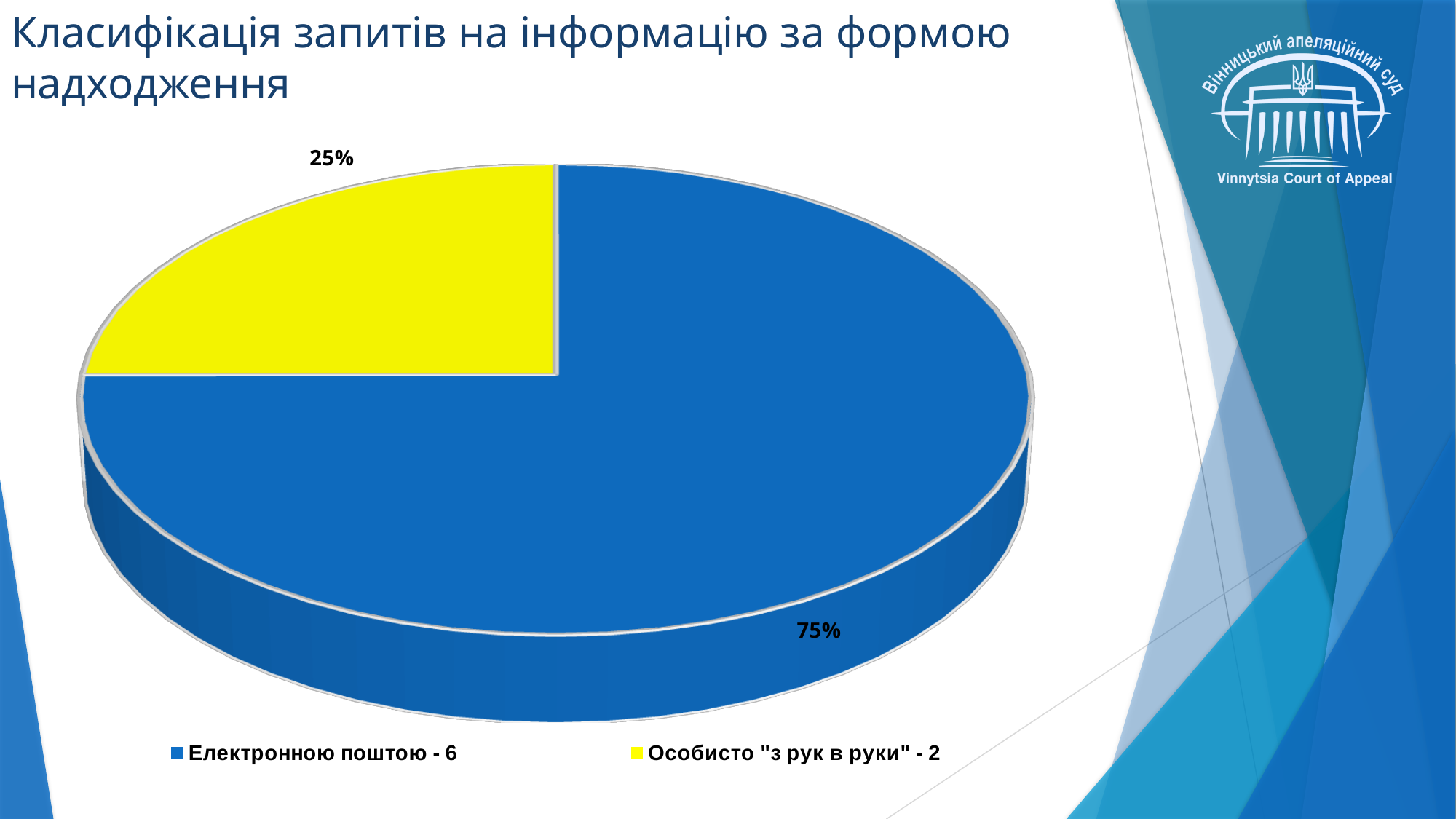
What share of the pie does the "Електронною поштою - 6" slice represent? 75% What share of the pie does the "Особисто "з рук в руки" - 2" slice represent? 25% How many slices does the pie chart have? 2 What colour is the "Особисто "з рук в руки" - 2" slice? yellow What kind of chart is shown on the slide? pie chart Which slice is larger: "Електронною поштою" or "Особисто "з рук в руки""? Електронною поштою What is the title of the slide containing the chart? Класифікація запитів на інформацію за формою надходження How many requests were received by e-mail according to the legend? 6 What is the difference in percentage points between the "Електронною поштою" slice and the "Особисто "з рук в руки"" slice? 50% How many entries does the legend list? 2 Which category has the largest slice of the pie? Електронною поштою - 6 Which category has the smallest slice of the pie? Особисто "з рук в руки" - 2